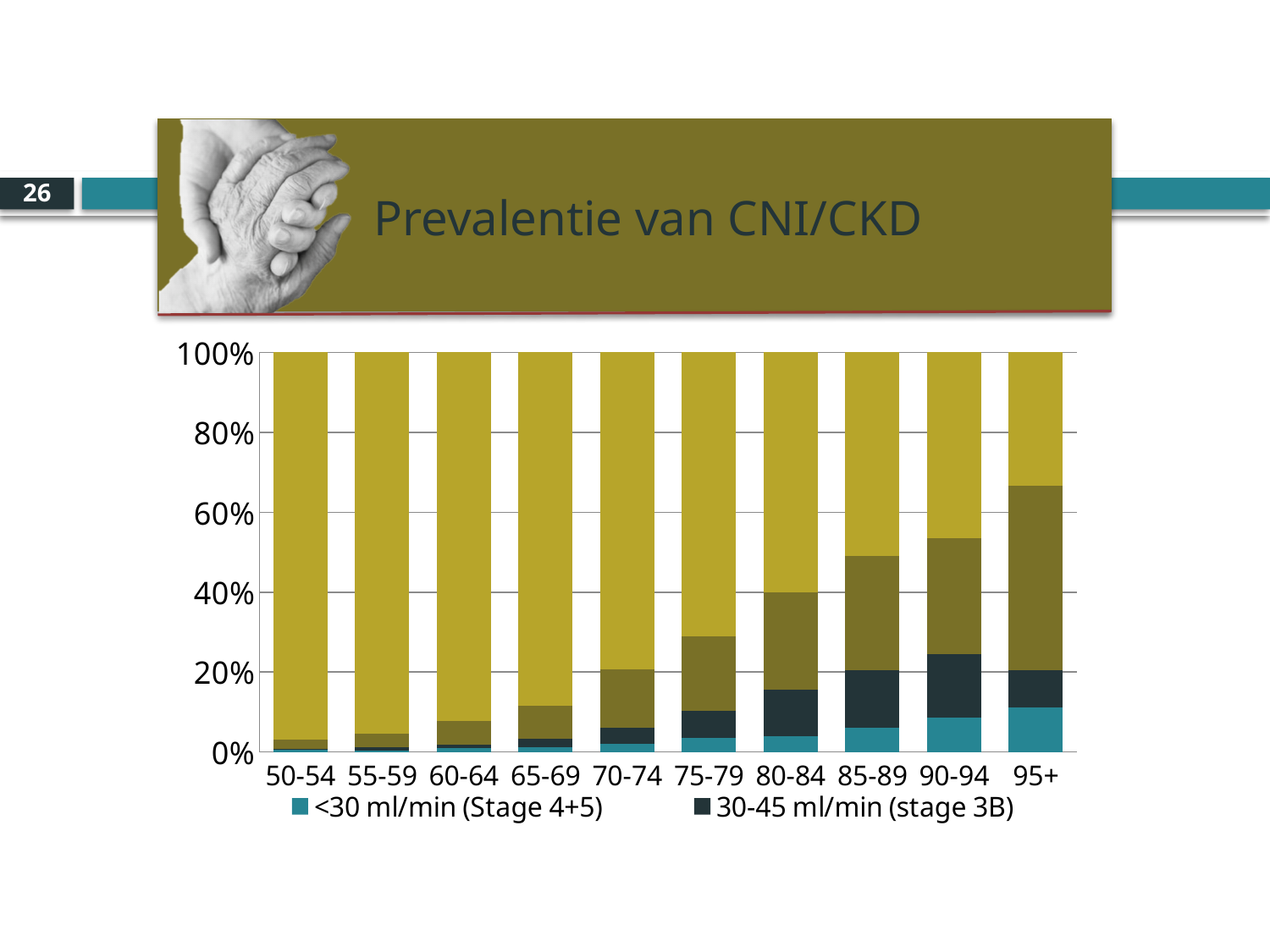
How many age groups are shown on the x axis of the chart? 10 What is the title of the slide containing the chart? Prevalentie van CNI/CKD What kind of chart is shown on the slide? Stacked bar chart How many series does the chart's legend list? 2 Which age group has a larger share for <30 ml/min (Stage 4+5), 50-54 or 95+? 95+ Is the combined share of <30 ml/min (Stage 4+5) and 30-45 ml/min (stage 3B) in the 90-94 age group greater or less than 20%? greater Which age group has the largest share for <30 ml/min (Stage 4+5)? 95+ Does the share for <30 ml/min (Stage 4+5) rise or fall as age increases along the x axis? Rise Which legend entry is shown in the teal colour? <30 ml/min (Stage 4+5) Is the share for <30 ml/min (Stage 4+5) in the 90-94 age group greater or less than 20%? less Is the share for 30-45 ml/min (stage 3B) in the 50-54 age group greater or less than 20%? less